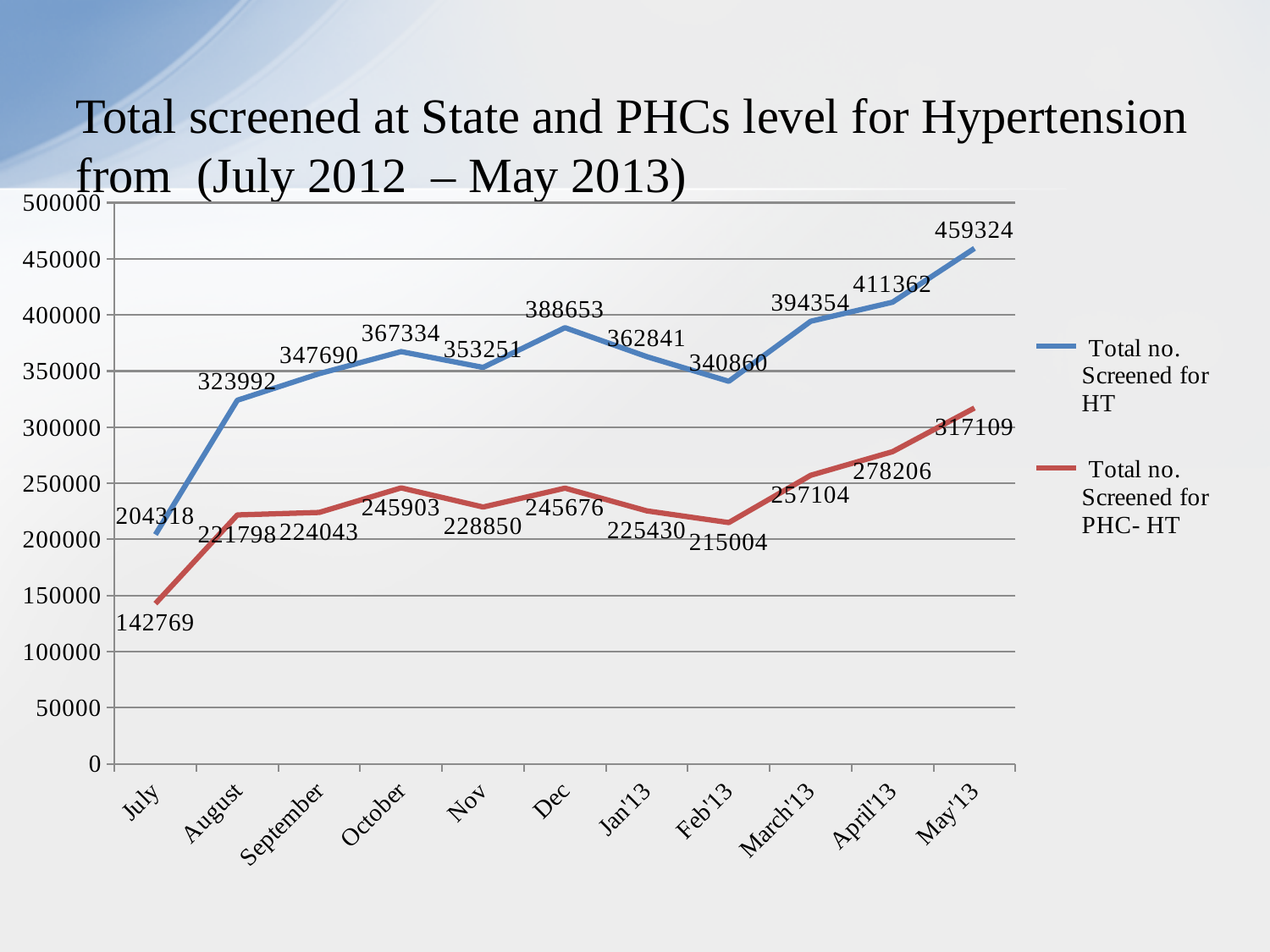
In which month is Total no. Screened for HT highest? May'13 Is the value for Total no. Screened for PHC- HT in Feb'13 greater or less than 250000? less How many series does the legend list? 2 What is the value of Total no. Screened for PHC- HT in July? 142769 Does Total no. Screened for HT rise or fall from Feb'13 to May'13? rise What kind of chart is shown on the slide? line chart How many months are plotted on the x axis? 11 Which is larger for Total no. Screened for HT: Dec or Jan'13? Dec What is the difference between Total no. Screened for HT in Dec and in Nov? 35402 In which month is Total no. Screened for PHC- HT lowest? July What is the difference between Total no. Screened for HT and Total no. Screened for PHC- HT in May'13? 142215 What is the value of Total no. Screened for HT in May'13? 459324